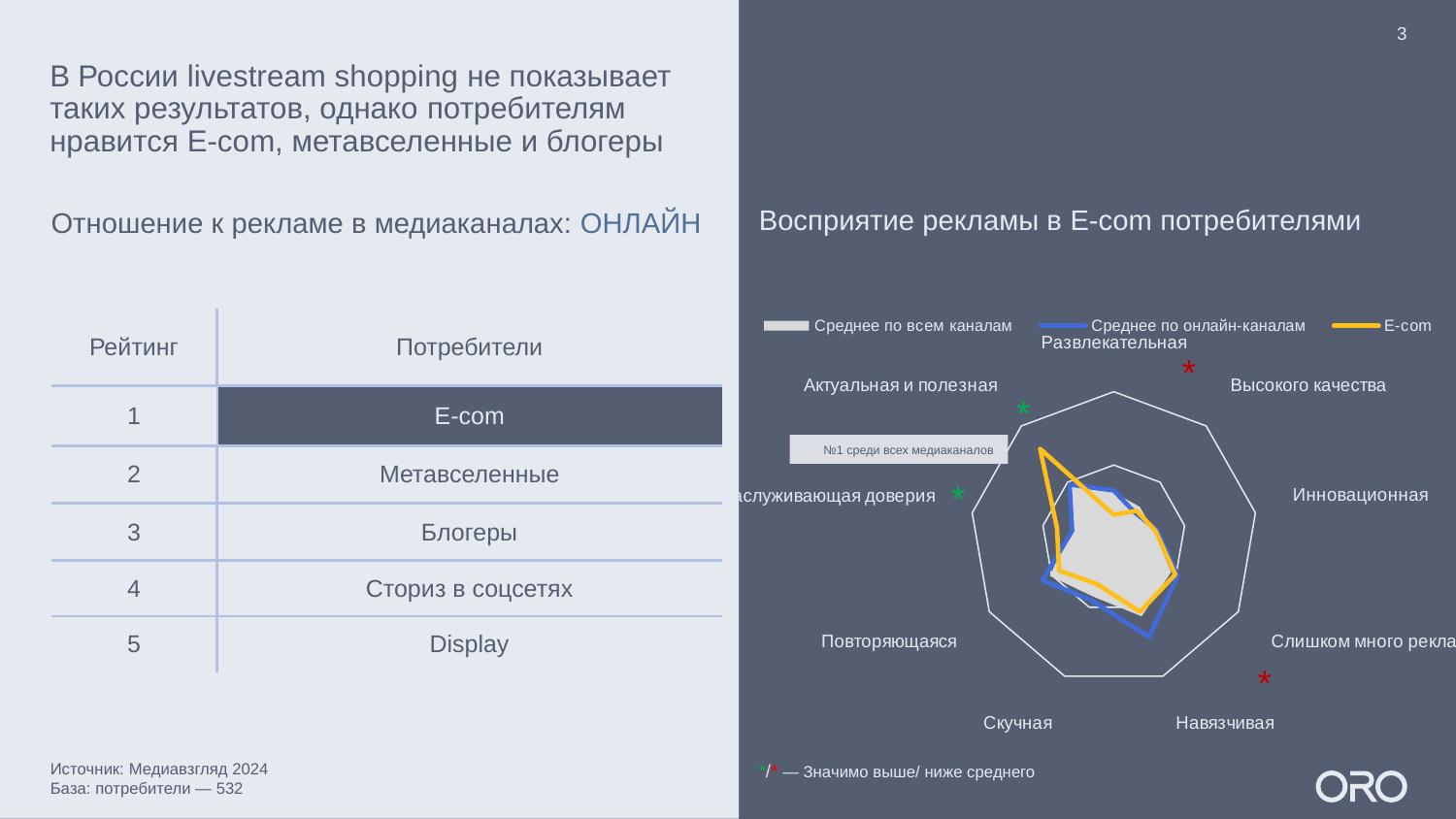
On which category does the E-com series reach its highest value in the radar chart? Актуальная и полезная How many categories (axes) does the radar chart have? 9 Which series in the radar chart is drawn in blue? Среднее по онлайн-каналам For the category "Развлекательная", which is larger: the E-com value or the value for "Среднее по всем каналам"? Среднее по всем каналам How many series does the legend of the radar chart list? 3 For the category "Развлекательная", which is larger: the E-com value or the value for "Среднее по онлайн-каналам"? Среднее по онлайн-каналам What kind of chart is shown under the title "Восприятие рекламы в E-com потребителями"? Radar chart Which series in the radar chart is drawn in yellow? E-com